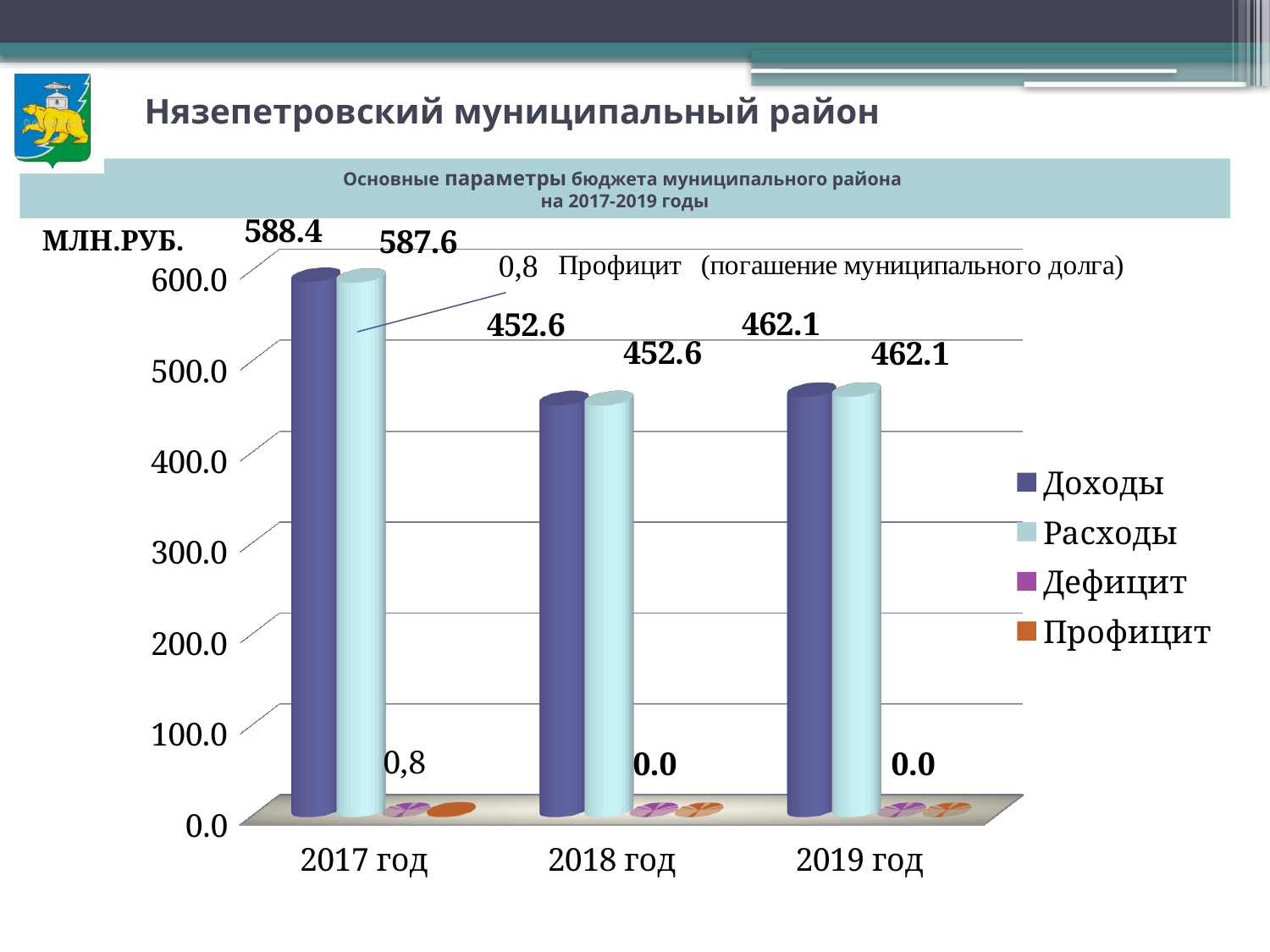
What is the value of Расходы for 2017 год? 587.6 What is the value of Доходы for 2018 год? 452.6 What kind of chart is shown on the slide? bar chart How many series does the legend list? 4 What is the value of Доходы for 2017 год? 588.4 What is the difference between Доходы and Расходы in 2017 год? 0.8 What is the value of Профицит for 2017 год? 0,8 Which is larger: Доходы in 2019 год or Доходы in 2018 год? Доходы in 2019 год In which year is Доходы highest? 2017 год In which year is Расходы lowest? 2018 год How many years are shown on the x axis? 3 What is the value of Расходы for 2019 год? 462.1